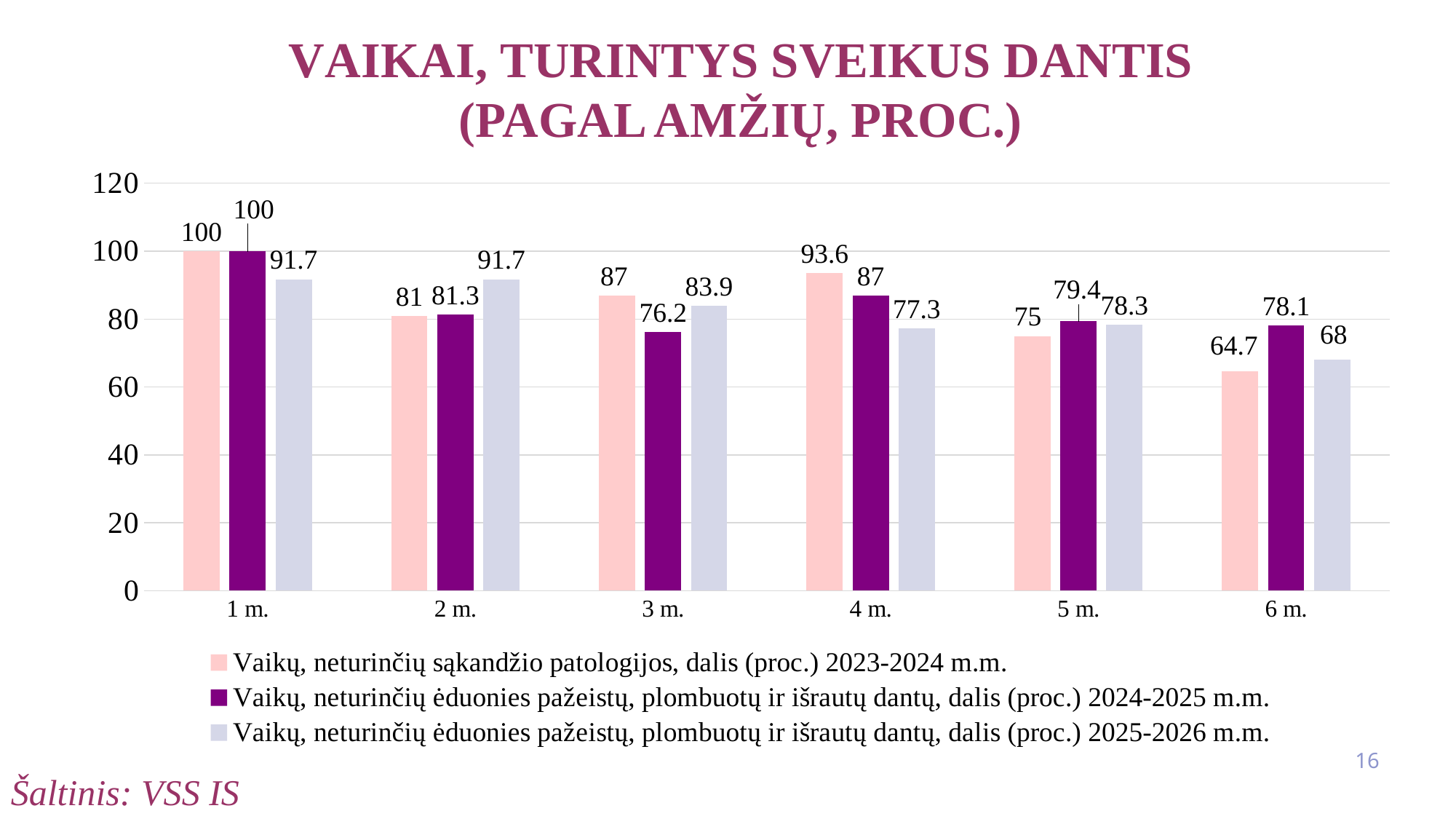
What is the value for 4 m. in the 2025-2026 m.m. series? 77.3 Which age group has the highest value in the 2023-2024 m.m. series? 1 m. Do the values in the 2023-2024 m.m. series generally rise or fall from 1 m. to 6 m.? fall How many age groups are shown on the x axis? 6 What is the difference between the 2023-2024 m.m. value and the 2025-2026 m.m. value for 4 m.? 16.3 What source is cited at the bottom of the slide? VSS IS What is the value for 3 m. in the 2024-2025 m.m. series? 76.2 How many series does the legend list? 3 What kind of chart is shown on the slide? bar chart What is the value for 6 m. in the 2023-2024 m.m. series? 64.7 Which age group has the lowest value in the 2025-2026 m.m. series? 6 m. For 5 m., which series has the larger value: 2023-2024 m.m. or 2024-2025 m.m.? 2024-2025 m.m.